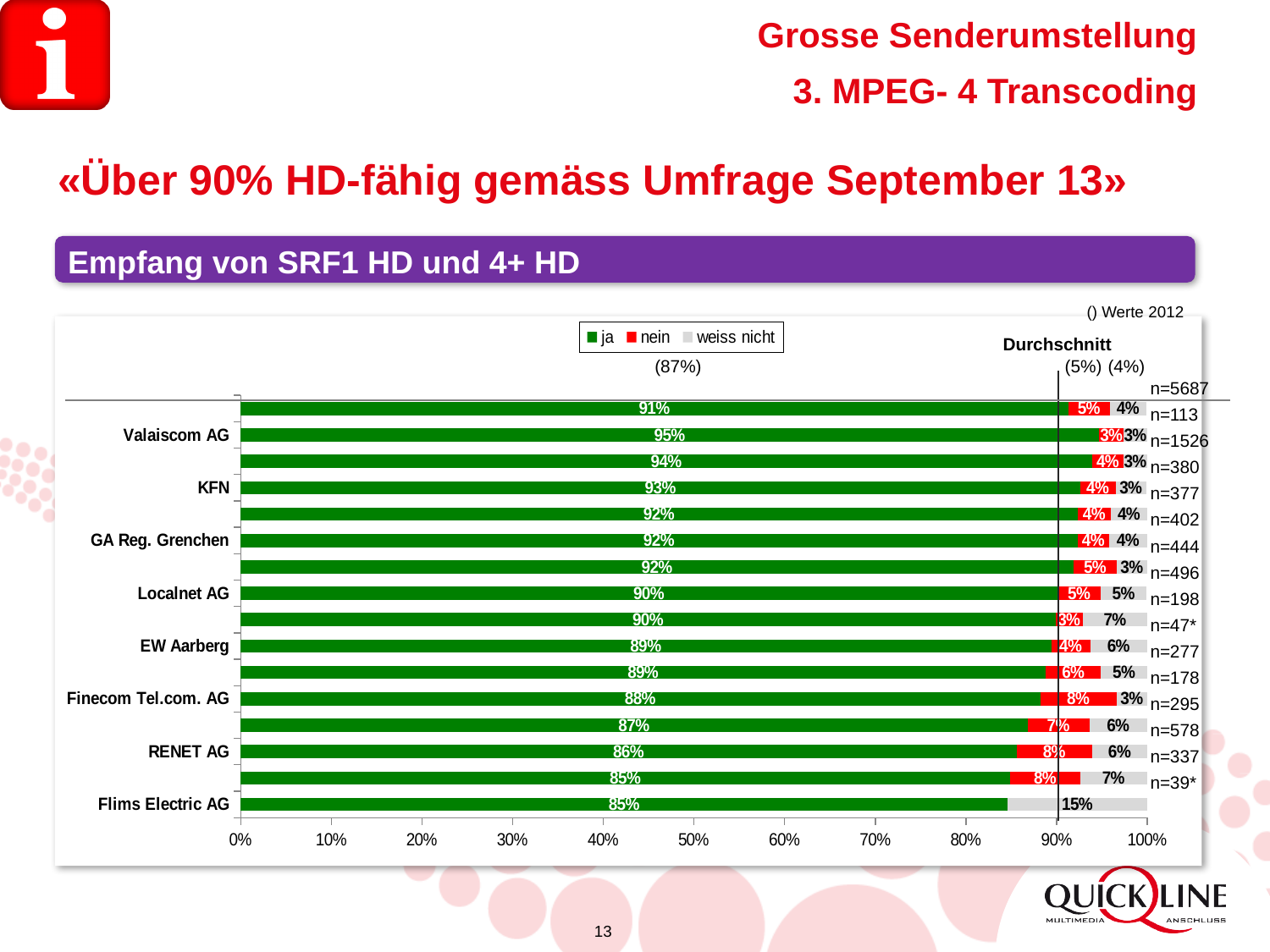
Which has a higher "ja" value, KFN or Localnet AG? KFN What are the three legend entries of the chart? ja, nein, weiss nicht What is the "weiss nicht" value for Flims Electric AG? 15% What is the difference in percentage points between the "ja" values of Valaiscom AG and RENET AG? 9 percentage points Which labelled provider has the highest "ja" share? Valaiscom AG What is the "weiss nicht" value for EW Aarberg? 6% What kind of chart is shown on the slide? Stacked horizontal bar chart Which labelled provider has the highest "weiss nicht" share? Flims Electric AG What is the "ja" value for Valaiscom AG? 95% Do the "ja" values rise or fall going from the top bar to the bottom bar? Fall How many series does the legend list? 3 What is the "nein" value for Finecom Tel.com. AG? 8%